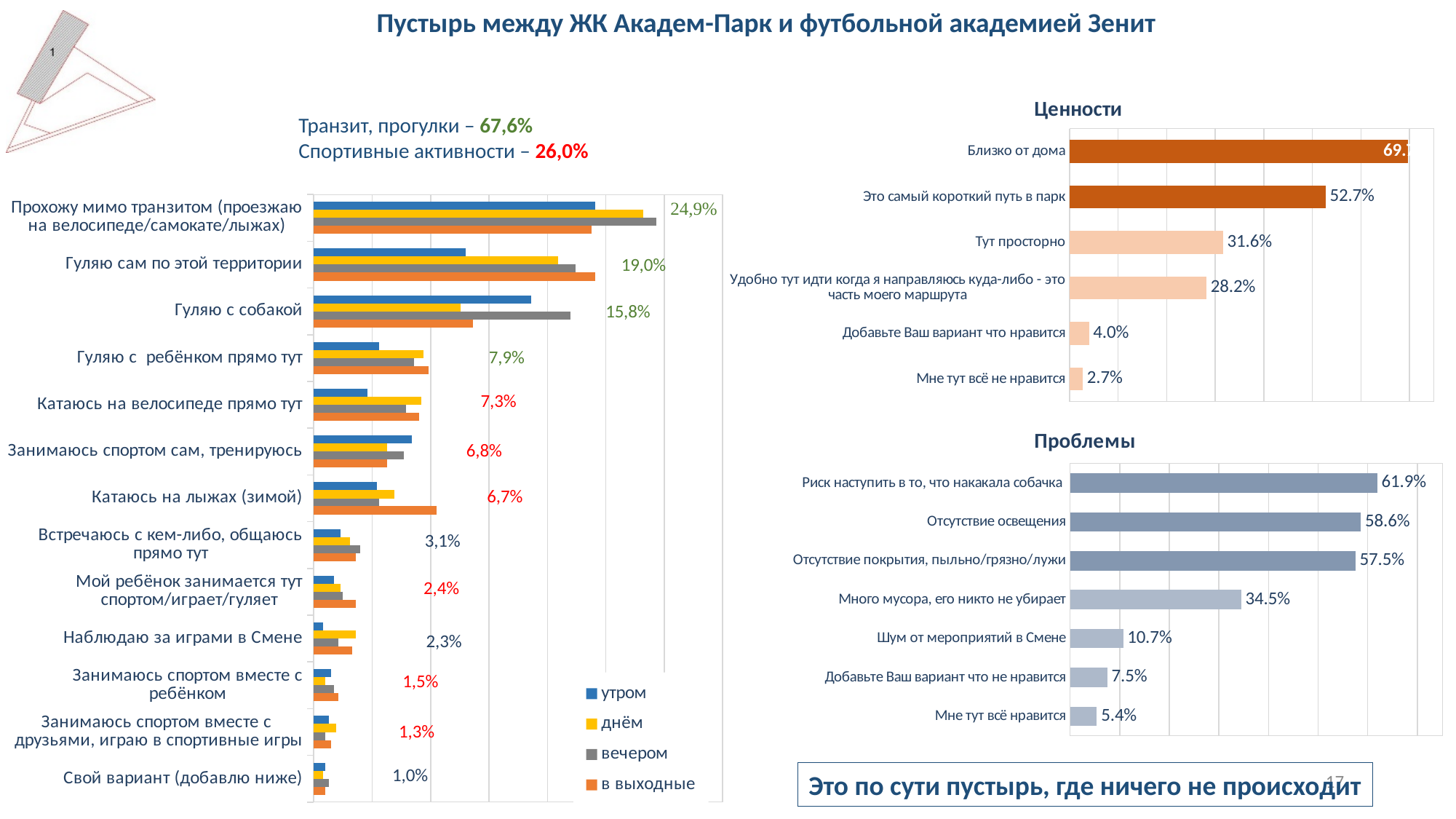
In the 'Ценности' chart, what is the value for 'Тут просторно'? 31.6% In the 'Проблемы' chart, what is the value for 'Отсутствие освещения'? 58.6% In the large chart on the left, which has the larger percentage label: 'Гуляю с собакой' or 'Гуляю с ребёнком прямо тут'? Гуляю с собакой In the large chart on the left, what is the percentage label shown for 'Гуляю с собакой'? 15,8% In the 'Проблемы' chart, which category has the lowest value? Мне тут всё нравится How many series does the legend of the large chart on the left list? 4 What kind of chart is the large chart on the left of the slide? Bar chart In the 'Проблемы' chart, what is the difference between 'Много мусора, его никто не убирает' and 'Шум от мероприятий в Смене'? 23.8% In the 'Ценности' chart, which category has the lowest value? Мне тут всё не нравится How many categories are shown in the 'Проблемы' chart? 7 In the 'Ценности' chart, what is the difference between 'Это самый короткий путь в парк' and 'Удобно тут идти когда я направляюсь куда-либо - это часть моего маршрута'? 24.5% In the 'Проблемы' chart, which category has the highest value? Риск наступить в то, что накакала собачка